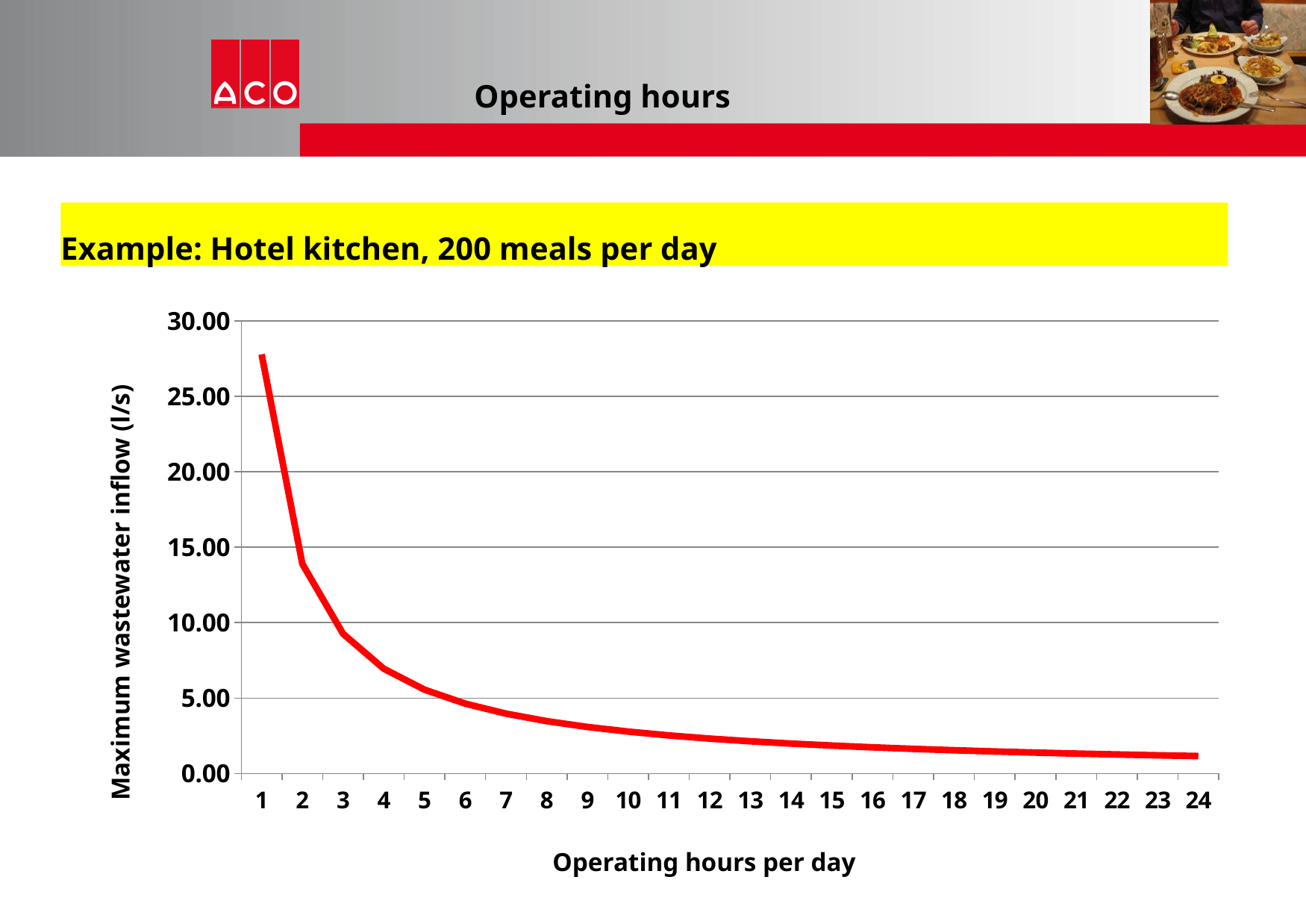
What is the label of the y axis? Maximum wastewater inflow (l/s) What kind of chart is shown on the slide? line chart Is the maximum wastewater inflow at 3 operating hours per day greater or less than 5.00 l/s? greater Is the maximum wastewater inflow at 2 operating hours per day greater or less than 15.00 l/s? less Which has the larger maximum wastewater inflow: 4 operating hours per day or 10 operating hours per day? 4 operating hours per day How many operating-hour points are plotted along the x axis? 24 What example scenario does the chart describe, according to the highlighted text above it? Hotel kitchen, 200 meals per day How do the values change as operating hours per day increase along the x axis? they fall Is the maximum wastewater inflow at 12 operating hours per day greater or less than 5.00 l/s? less At which number of operating hours per day is the maximum wastewater inflow highest? 1 At which number of operating hours per day is the maximum wastewater inflow lowest? 24